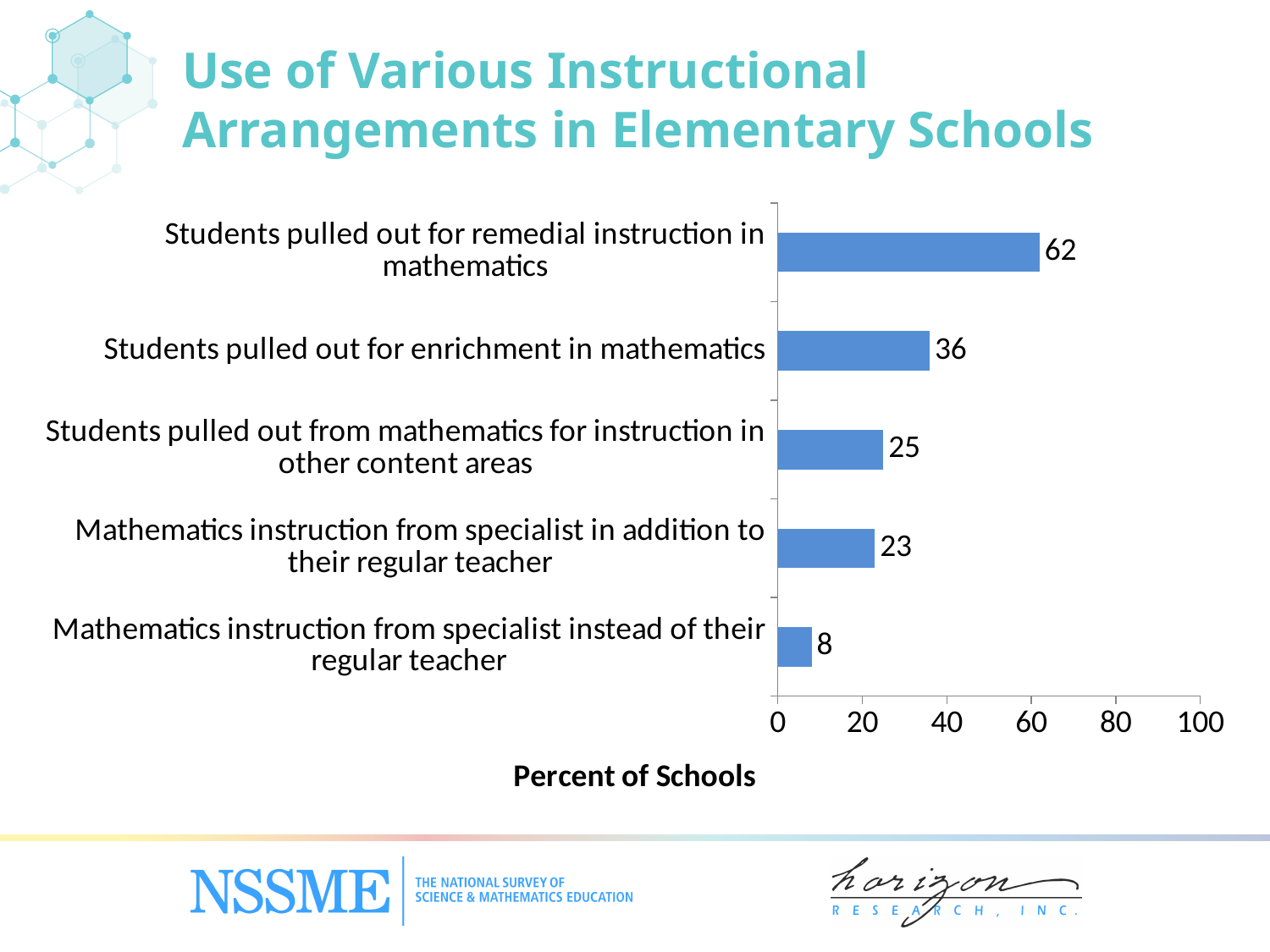
What is the difference between the value for students pulled out from mathematics for instruction in other content areas and the value for mathematics instruction from specialist in addition to their regular teacher? 2 Which is larger: the value for students pulled out for enrichment in mathematics or the value for students pulled out from mathematics for instruction in other content areas? Students pulled out for enrichment in mathematics What is the difference between the value for students pulled out for remedial instruction in mathematics and the value for students pulled out for enrichment in mathematics? 26 Which instructional arrangement has the lowest percent of schools? Mathematics instruction from specialist instead of their regular teacher How many instructional arrangements are shown in the chart? 5 Which instructional arrangement has the highest percent of schools? Students pulled out for remedial instruction in mathematics What percent of schools have students pulled out for remedial instruction in mathematics? 62 What is the value for mathematics instruction from specialist in addition to their regular teacher? 23 What kind of chart is shown on the slide? Bar chart What percent of schools provide mathematics instruction from a specialist instead of their regular teacher? 8 What is the value for students pulled out for enrichment in mathematics? 36 Is the value for students pulled out for remedial instruction in mathematics greater or less than 60? greater